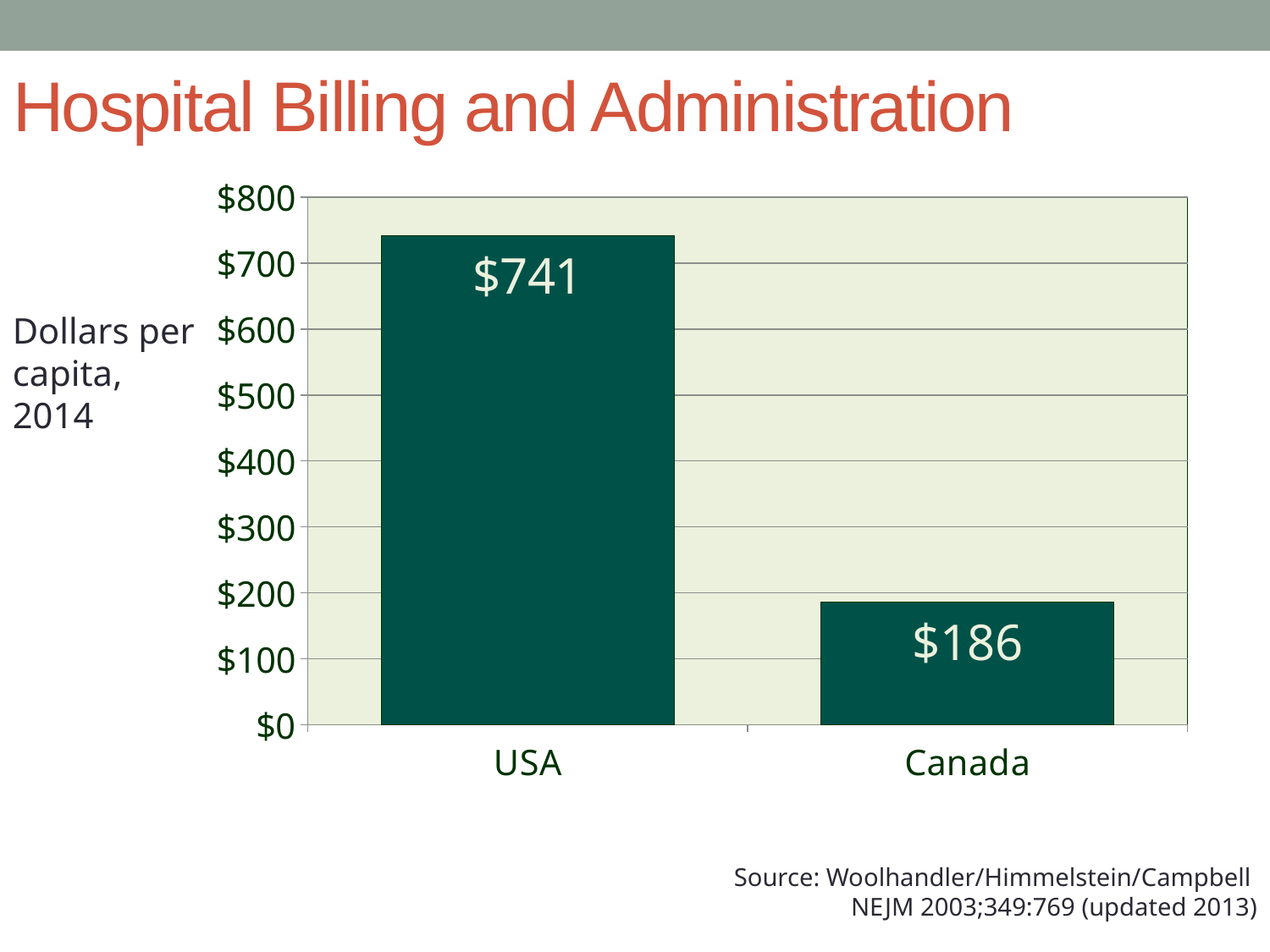
What is the value for Canada? $186 What is the title of the slide? Hospital Billing and Administration Which category has the lowest value? Canada How many categories are shown in the chart? 2 Is the value for USA greater or less than $700? greater What unit is given for the y axis values? Dollars per capita, 2014 Which is larger, the value for USA or the value for Canada? USA What is the value for USA? $741 Which category has the highest value? USA Is the value for Canada greater or less than $200? less What is the difference between the values for USA and Canada? $555 What kind of chart is shown on the slide? bar chart